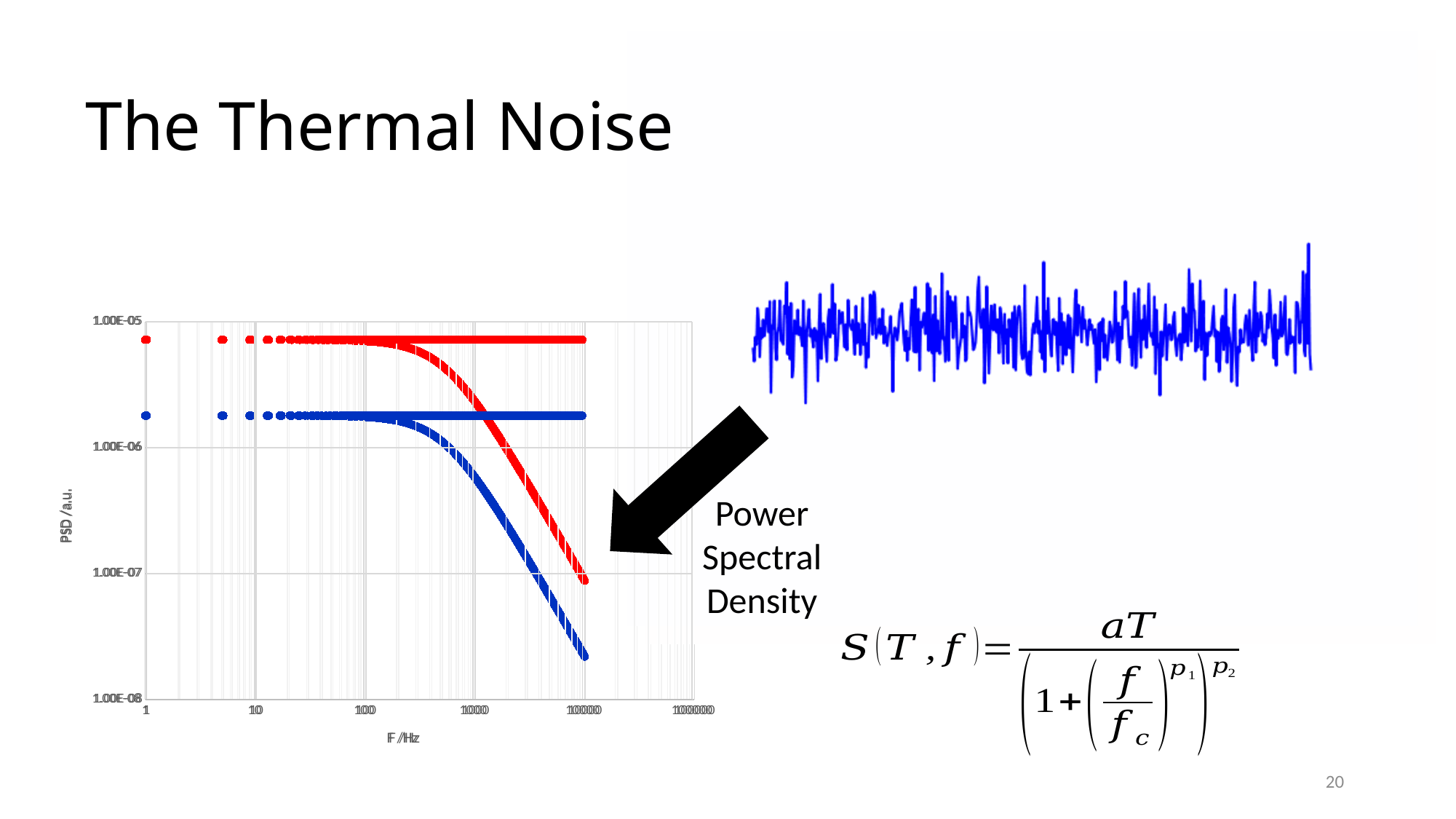
In the PSD chart, which series has the higher values, the red one or the blue one? red What is the label of the x axis of the PSD chart? F /Hz In the PSD chart, is the value of the blue series at 1 Hz greater or less than 1.00E-06? greater In the PSD chart, is the value of the red series at 1 Hz greater or less than 1.00E-06? greater In the PSD chart, is the value of the blue series at 10000 Hz greater or less than 1.00E-07? less What is the label of the y axis of the PSD chart? PSD /a.u. What kind of chart is shown on the left of the slide? scatter chart In the PSD chart, do the values rise or fall as frequency increases beyond 1000 Hz? fall What is the highest tick value shown on the x axis of the PSD chart? 100000 How many data series are plotted in the PSD chart? 2 What is the lowest tick value shown on the y axis of the PSD chart? 1.00E-08